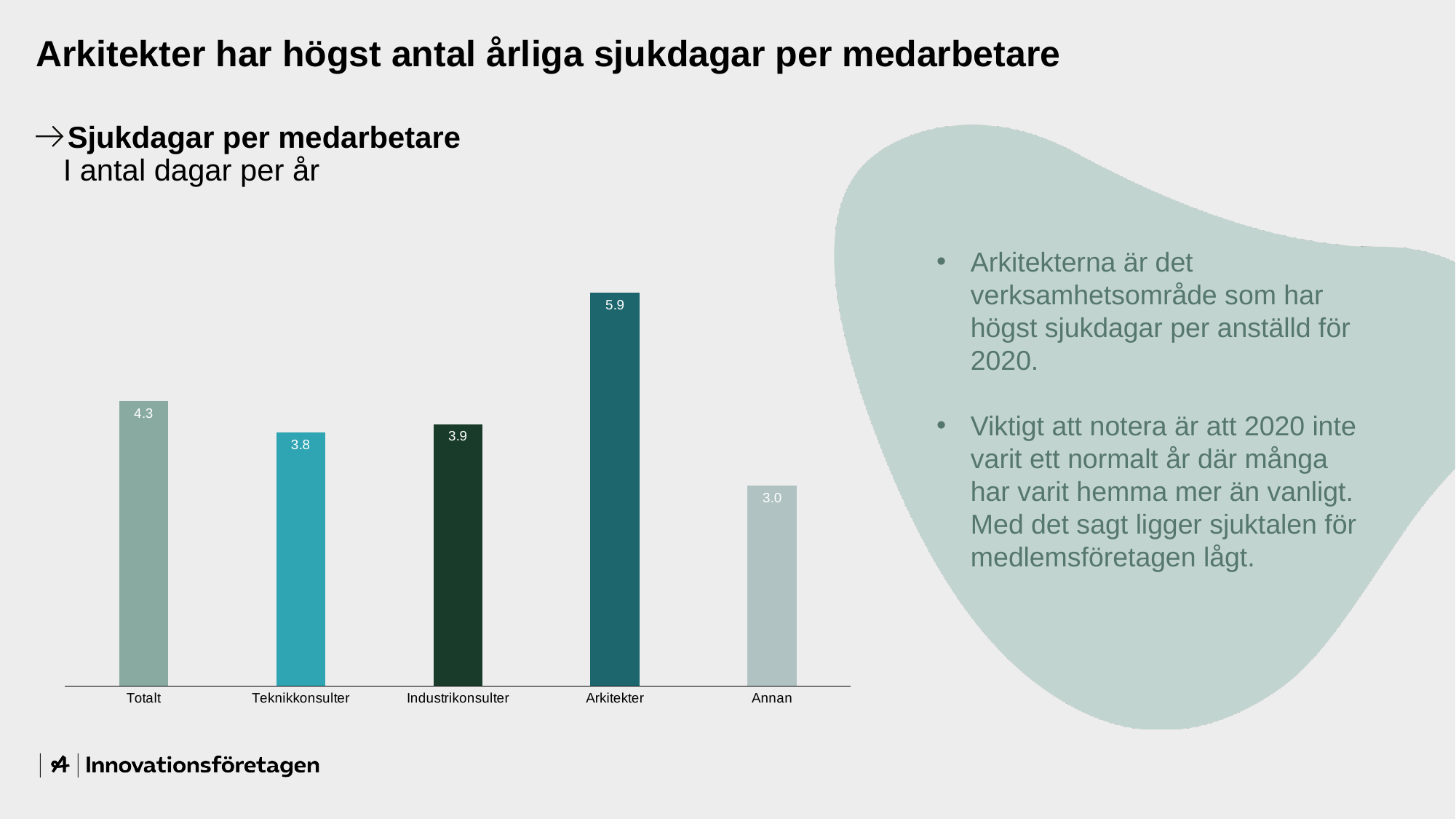
What is the value for Annan? 3.0 What is the difference between the values for Totalt and Industrikonsulter? 0.4 What kind of chart is shown on the slide? Bar chart What is the value for Arkitekter? 5.9 Which is larger, the value for Totalt or the value for Teknikkonsulter? Totalt How many categories are shown in the chart? 5 Which category has the highest value? Arkitekter What is the value for Teknikkonsulter? 3.8 What is the difference between the values for Arkitekter and Annan? 2.9 What is the value for Totalt? 4.3 Which category has the lowest value? Annan What is the title of the chart? Sjukdagar per medarbetare